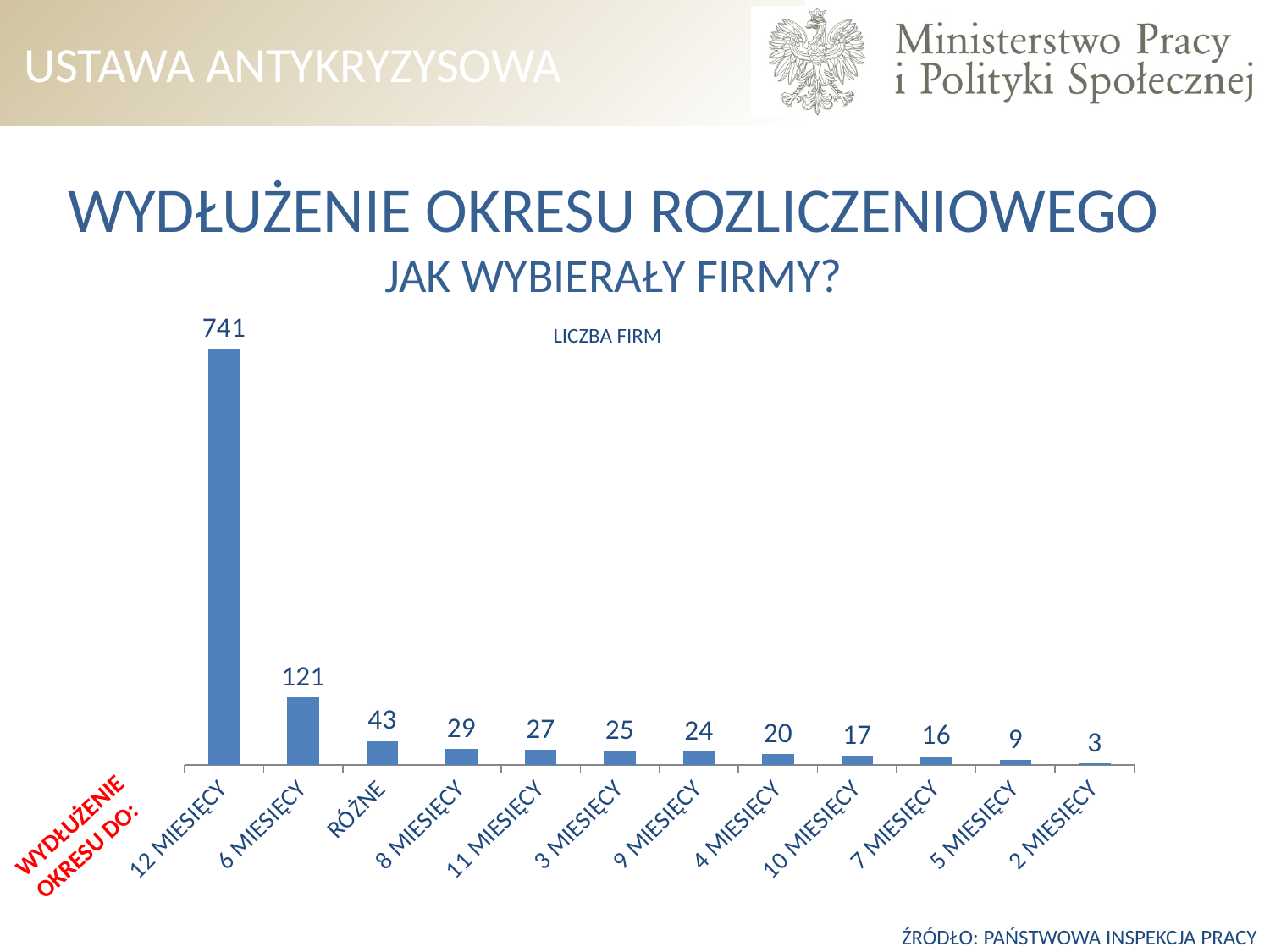
What is the value for 12 MIESIĘCY? 741 What kind of chart is shown on the slide? bar chart What is the value for 6 MIESIĘCY? 121 Which category has the highest value? 12 MIESIĘCY Which is larger, the value for 8 MIESIĘCY or the value for 4 MIESIĘCY? 8 MIESIĘCY What is the title of the chart? LICZBA FIRM What is the difference between the values for 12 MIESIĘCY and 6 MIESIĘCY? 620 Do the values rise or fall from left to right along the x axis? fall Which category has the lowest value? 2 MIESIĘCY How many categories are shown on the x axis? 12 What is the value for RÓŻNE? 43 What is the value for 2 MIESIĘCY? 3